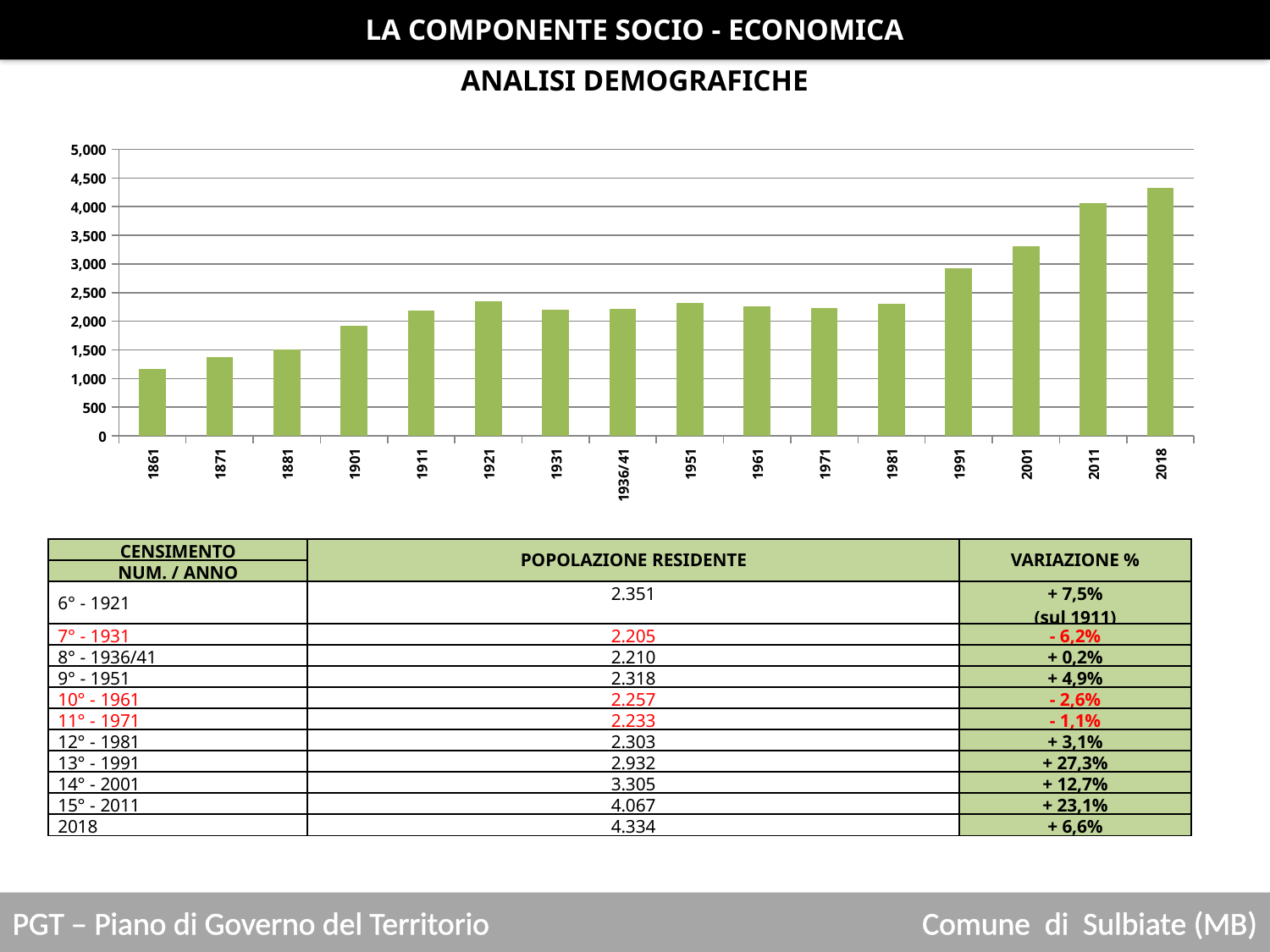
Which year has the lowest bar in the chart? 1861 Which is larger, the value for 2001 or the value for 1991? 2001 Is the value for 1901 greater or less than 1,500? greater What kind of chart is shown on the slide? bar chart Is the value for 2001 greater or less than 3,000? greater Overall, do the values rise or fall from 1861 to 2018? rise How many census years (bars) are shown on the x axis of the chart? 16 Is the value for 1861 greater or less than 1,500? less According to the table, what is the resident population for 13° - 1991? 2.932 According to the table, what is the resident population for 2018? 4.334 Which year has the highest bar in the chart? 2018 What is the difference between the resident population in 2018 and in 2011, using the values in the table? 267